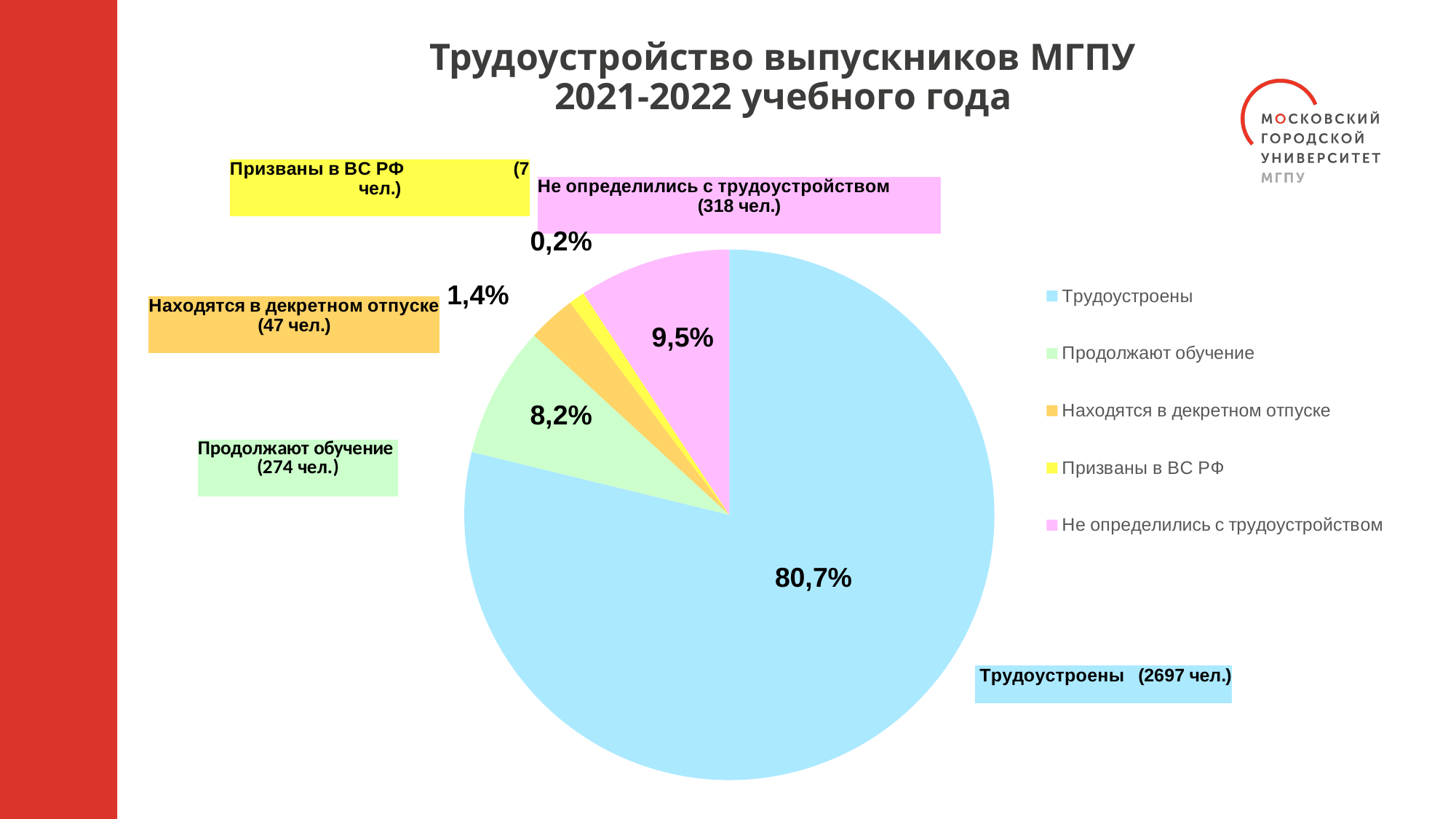
What percentage of graduates are shown as "Не определились с трудоустройством"? 9,5% How many people are in the "Находятся в декретном отпуске" category according to the label? 47 чел. How many categories does the legend list? 5 What percentage of graduates are shown as "Трудоустроены"? 80,7% How many people are in the "Трудоустроены" category according to the label? 2697 чел. What percentage of graduates are shown as "Призваны в ВС РФ"? 0,2% What is the difference in percentage points between "Трудоустроены" and "Не определились с трудоустройством"? 71,2 Which share is larger: "Продолжают обучение" or "Не определились с трудоустройством"? Не определились с трудоустройством Which category has the largest share of the pie? Трудоустроены Which category has the smallest share of the pie? Призваны в ВС РФ What kind of chart is shown on the slide? Pie chart What percentage of graduates are shown as "Продолжают обучение"? 8,2%